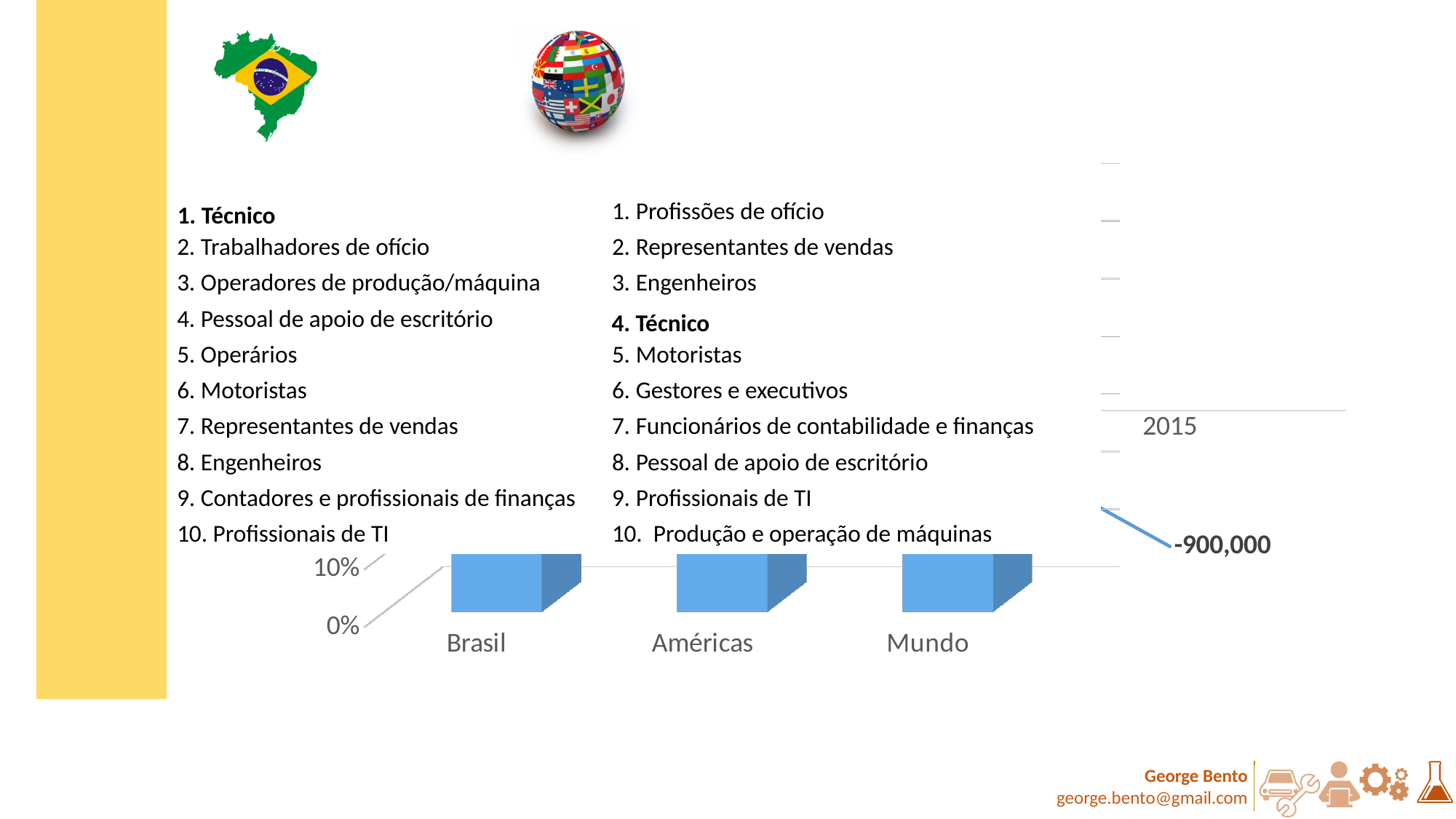
What are the category labels on the x axis of the bar chart at the bottom of the slide? Brasil, Américas, Mundo Which category is the first (leftmost) on the x axis of the bar chart at the bottom of the slide? Brasil In the line chart on the right side of the slide, what value is printed as the data label next to the line? -900,000 What are the two axis tick labels shown on the vertical axis of the bar chart at the bottom of the slide? 0% and 10% What kind of chart is shown at the bottom of the slide with the categories Brasil, Américas and Mundo? bar chart How many categories does the bar chart at the bottom of the slide show? 3 In the line chart on the right side of the slide, what year is shown on the x axis? 2015